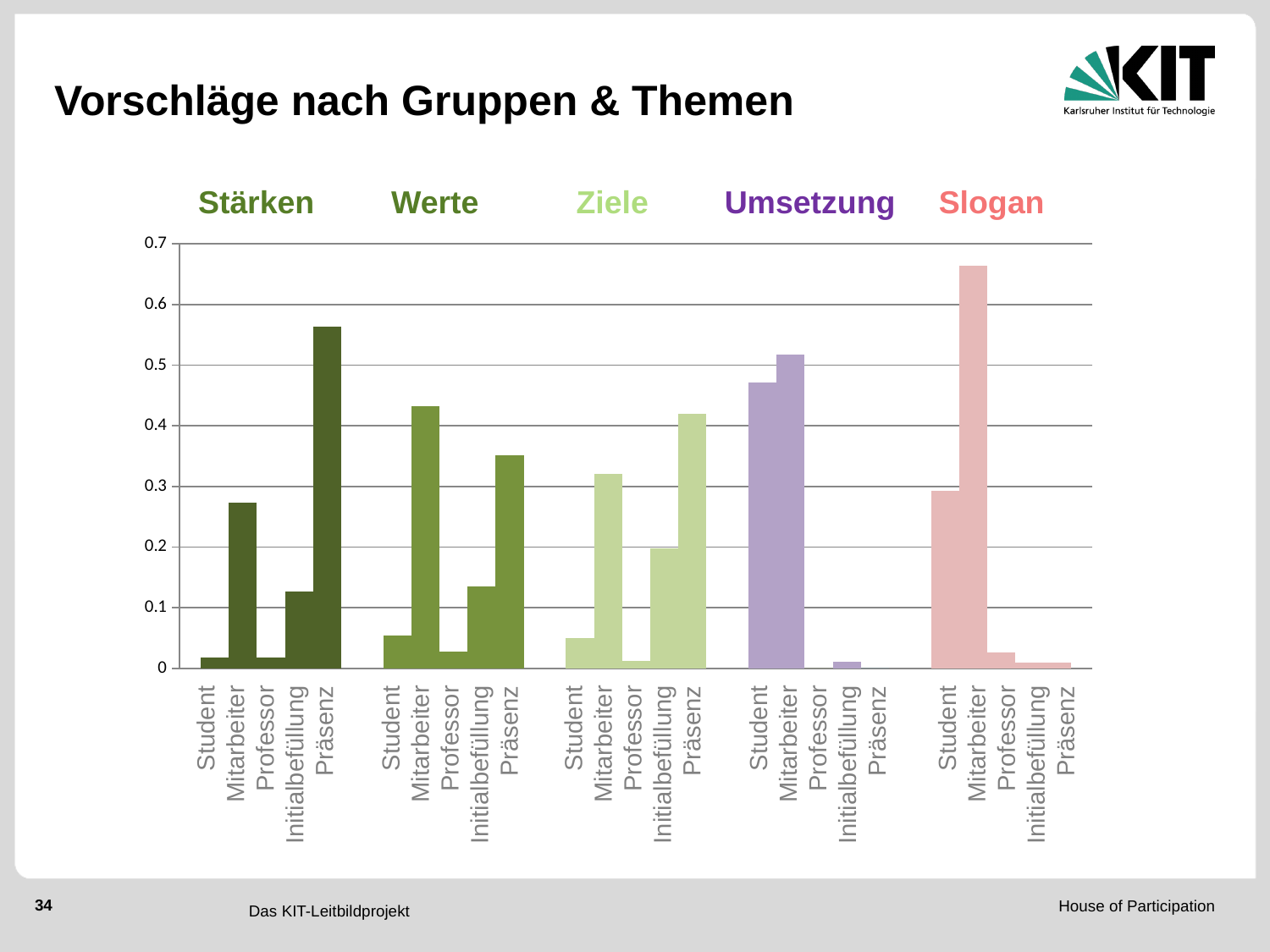
What kind of chart is shown on the slide? bar chart Within the Stärken group, which category has the highest bar? Präsenz What is the title of the slide containing the chart? Vorschläge nach Gruppen & Themen Which bar is the highest in the whole chart? Mitarbeiter in Slogan Which is larger: Student in the Umsetzung group or Student in the Slogan group? Student in the Umsetzung group Is the value for Präsenz in the Stärken group greater or less than 0.5? greater Within the Werte group, which category has the highest bar? Mitarbeiter How many topic groups (Stärken, Werte, etc.) are shown above the chart? 5 Is the value for Initialbefüllung in the Ziele group greater or less than 0.3? less How many bars are plotted in each topic group? 5 Which topic group's bars are coloured purple? Umsetzung Is the value for Mitarbeiter in the Slogan group greater or less than 0.6? greater